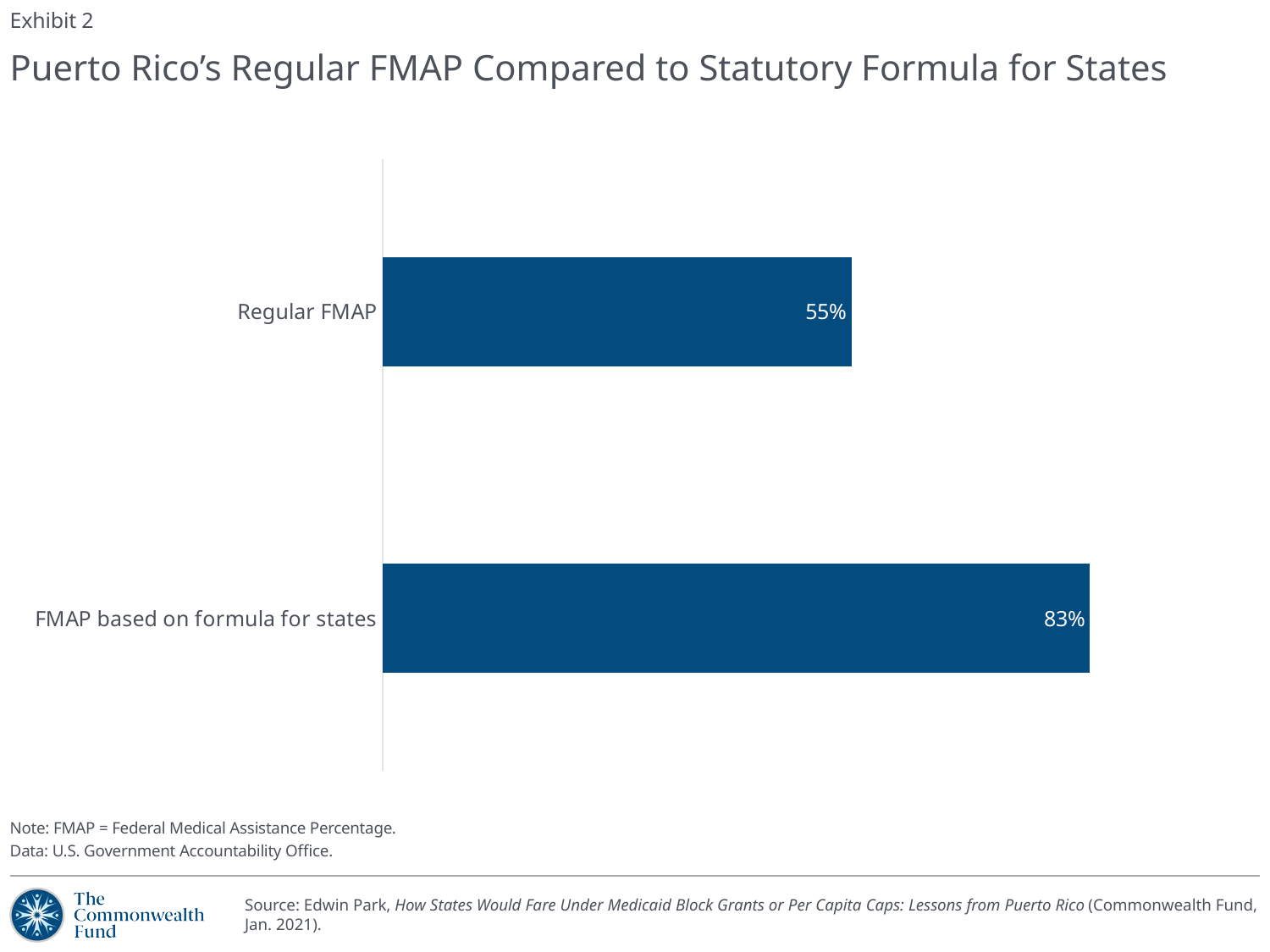
What is the value for Regular FMAP? 55% How many categories are shown in the chart? 2 Which category has the lowest value? Regular FMAP Which is larger, Regular FMAP or FMAP based on formula for states? FMAP based on formula for states What is the difference between the FMAP based on formula for states and the Regular FMAP? 28 percentage points What is the value for FMAP based on formula for states? 83% What is the title of the chart? Puerto Rico's Regular FMAP Compared to Statutory Formula for States Which category has the highest value? FMAP based on formula for states What kind of chart is shown on the slide? Bar chart According to the note, what does FMAP stand for? Federal Medical Assistance Percentage